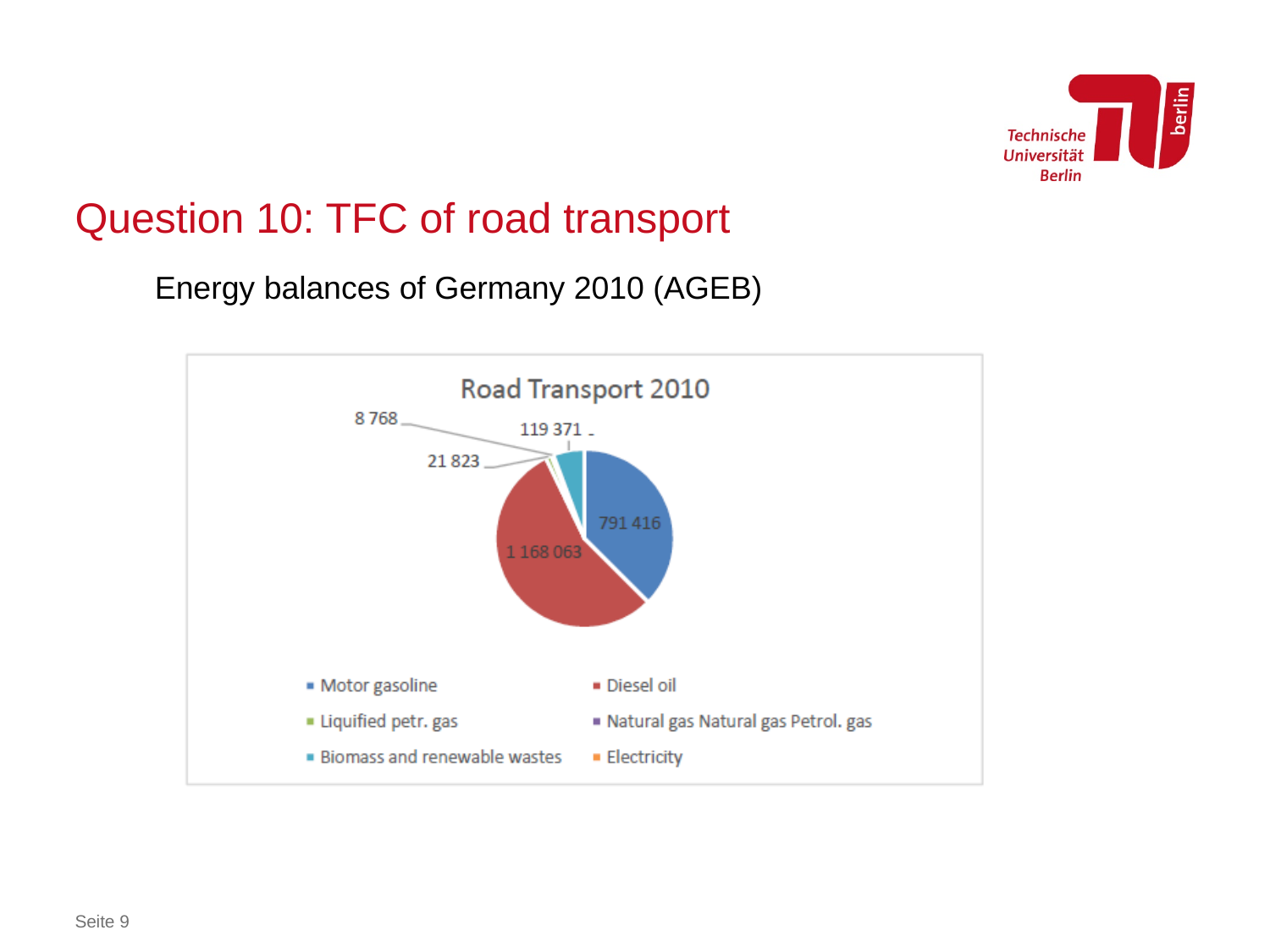
What is the value for Liquified petr. gas in the pie chart? 21 823 What colour is the Diesel oil slice in the pie chart? Red What is the value for Natural gas in the pie chart? 8 768 Which is larger, the value for Diesel oil or the value for Motor gasoline? Diesel oil What is the value for Biomass and renewable wastes in the pie chart? 119 371 How many categories does the legend of the pie chart list? 6 What is the value for Motor gasoline in the pie chart? 791 416 What is the title of the chart? Road Transport 2010 Which category has the largest slice in the pie chart? Diesel oil What is the difference between the values for Diesel oil and Motor gasoline? 376 647 What type of chart is shown on the slide? Pie chart What is the value for Diesel oil in the pie chart? 1 168 063